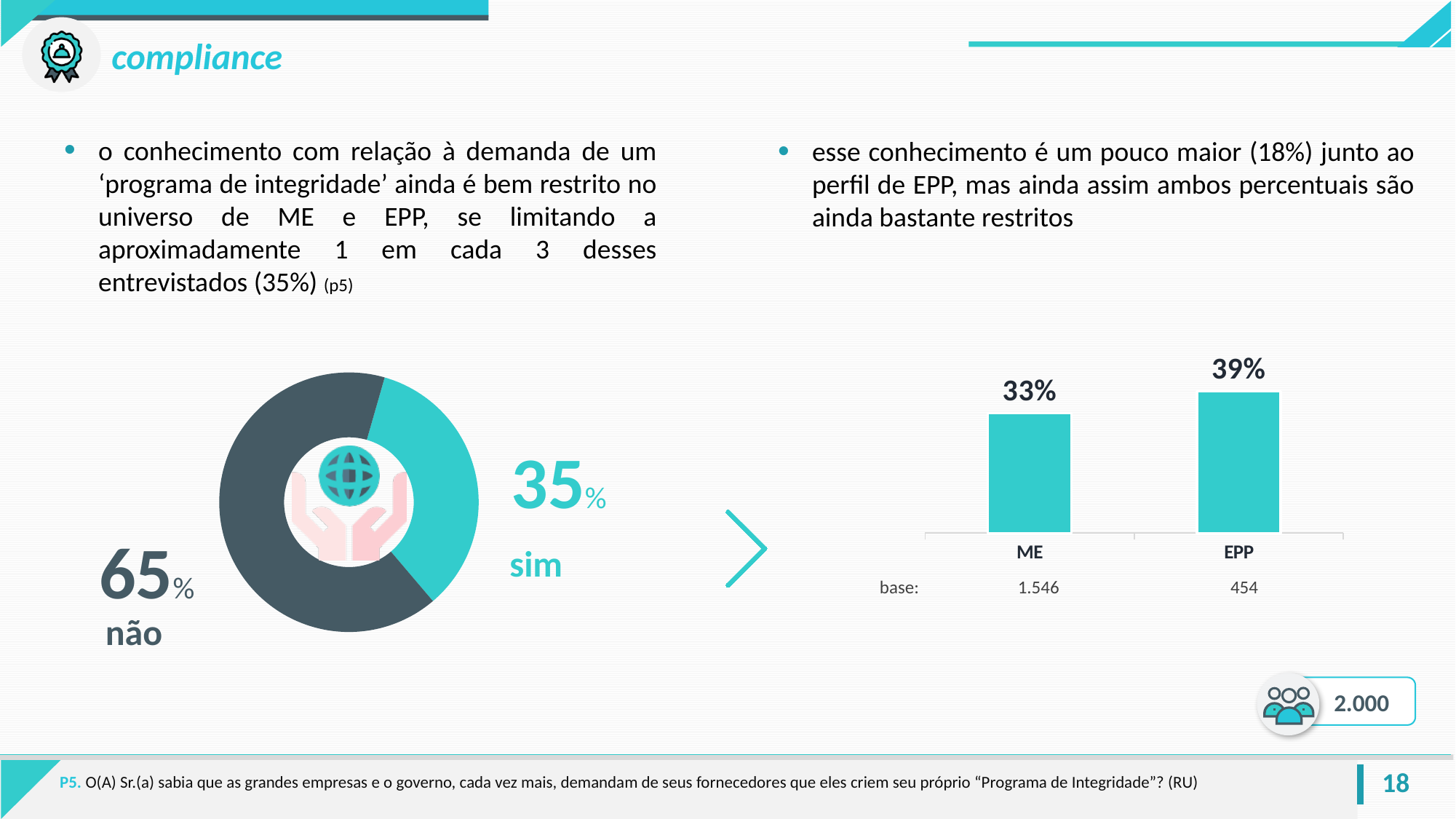
In the bar chart on the right, what is the value for ME? 33% In the bar chart on the right, what is the difference between the EPP and ME values? 6% In the donut chart on the left, how many slices are shown? 2 What kind of chart is shown on the left of the slide? Donut (pie) chart In the donut chart on the left, what percentage answered 'não'? 65% What kind of chart is shown on the right of the slide? Bar chart In the bar chart on the right, what is the value for EPP? 39% In the donut chart on the left, which answer has the larger share, 'sim' or 'não'? não In the donut chart on the left, what percentage answered 'sim'? 35% In the donut chart on the left, what is the difference between the 'não' and 'sim' shares? 30% In the bar chart on the right, which category has the higher value? EPP In the bar chart on the right, what is the base shown for ME? 1.546